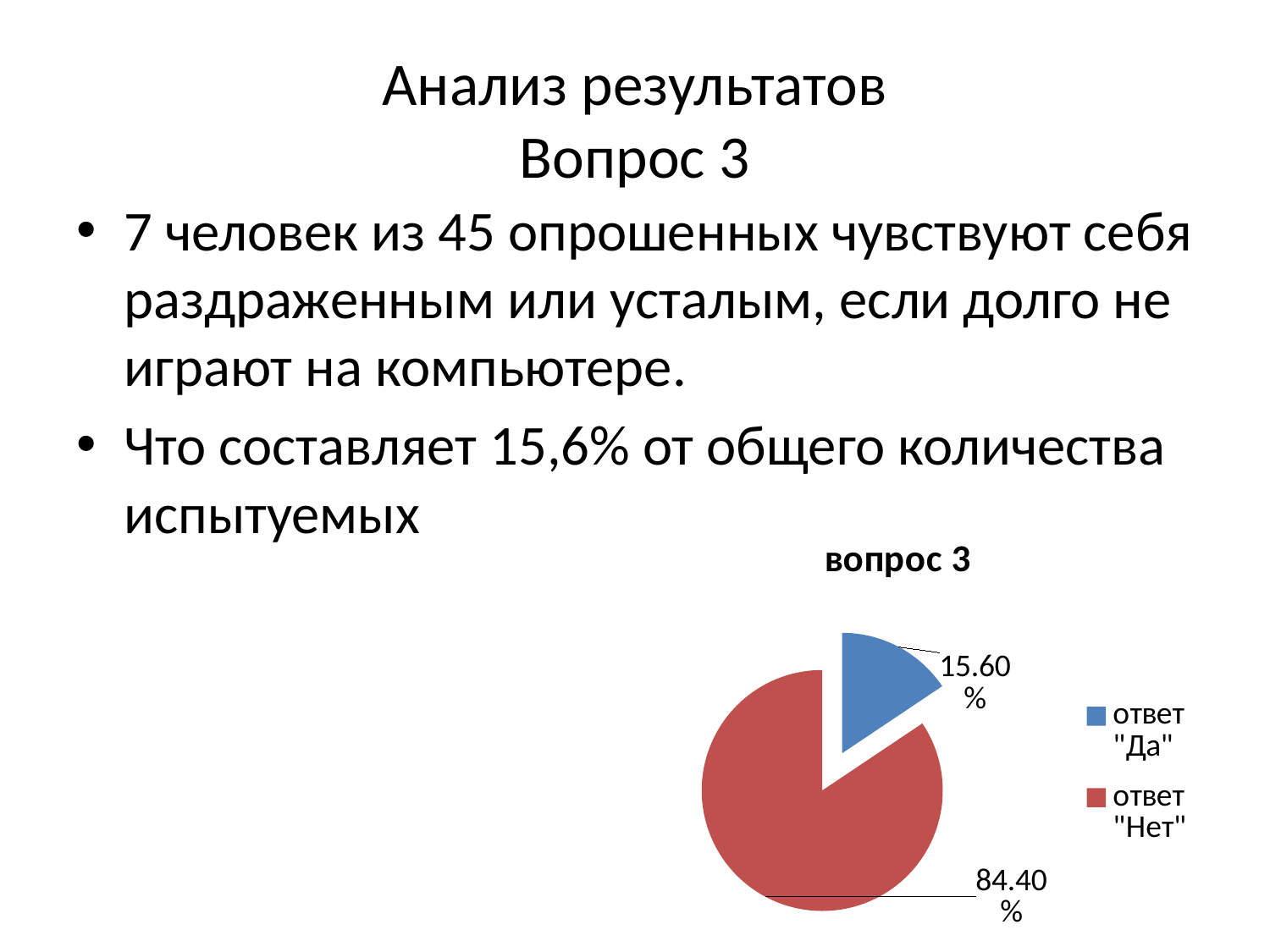
What share of the pie does ответ "Нет" represent? 84.40% How many slices does the pie chart have? 2 Which slice of the pie is the largest? ответ "Нет" Which is larger, the share for ответ "Да" or the share for ответ "Нет"? ответ "Нет" What colour is the slice for ответ "Да"? blue What share of the pie does ответ "Да" represent? 15.60% What is the title of the chart? вопрос 3 How many entries does the legend list? 2 What is the difference between the shares of ответ "Нет" and ответ "Да"? 68.80% Which slice of the pie is the smallest? ответ "Да" What type of chart is shown on the slide? pie chart